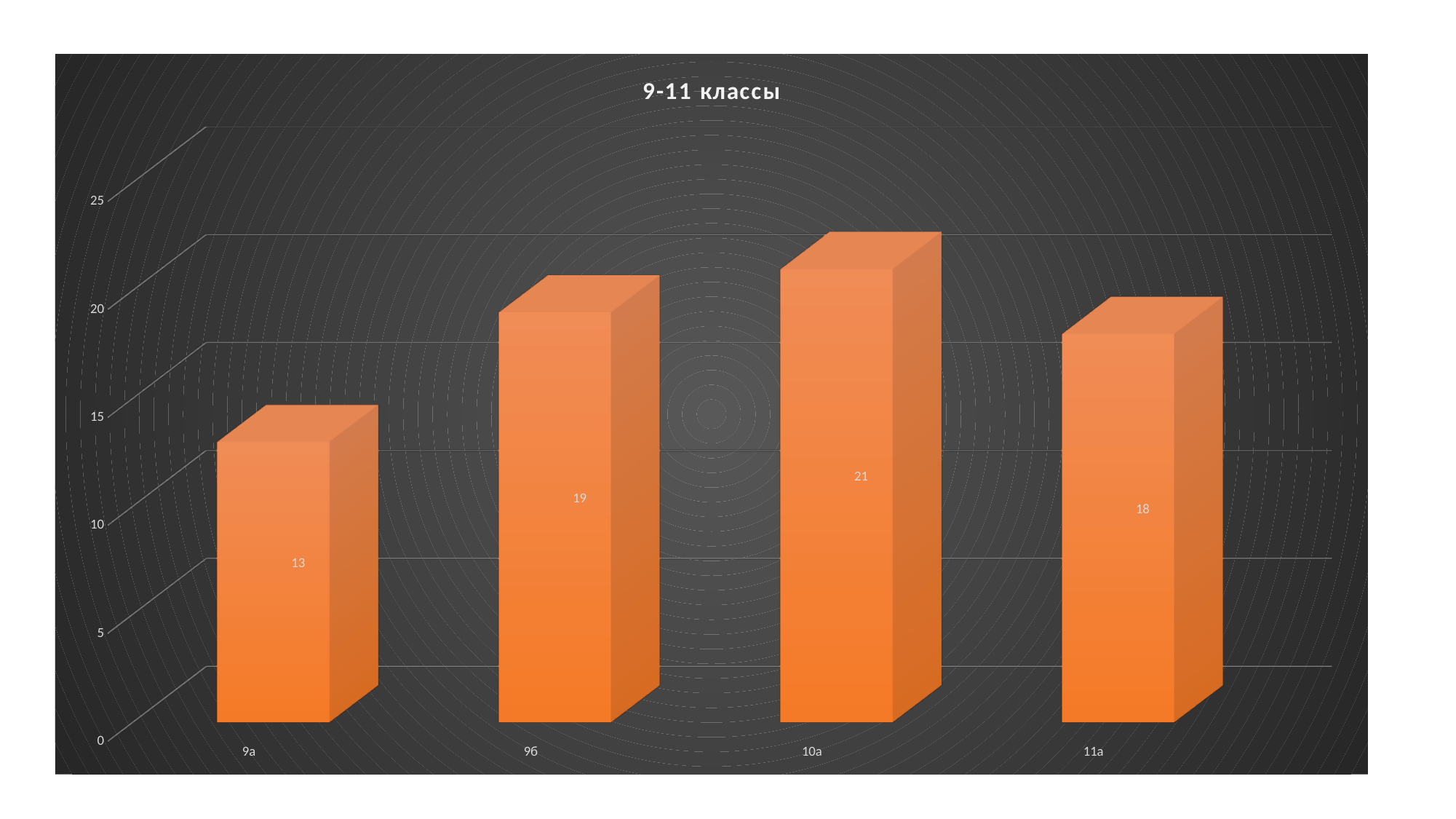
Which category has the lowest value? 9а What is the title of the chart? 9-11 классы What is the value for 9а? 13 What kind of chart is shown on the slide? bar chart What is the value for 10а? 21 What is the value for 9б? 19 How many categories are shown on the chart? 4 Is the value for 9а greater or less than 15? less What is the value for 11а? 18 What is the difference between the values for 10а and 9а? 8 Which is larger, the value for 9б or the value for 11а? 9б Which category has the highest value? 10а